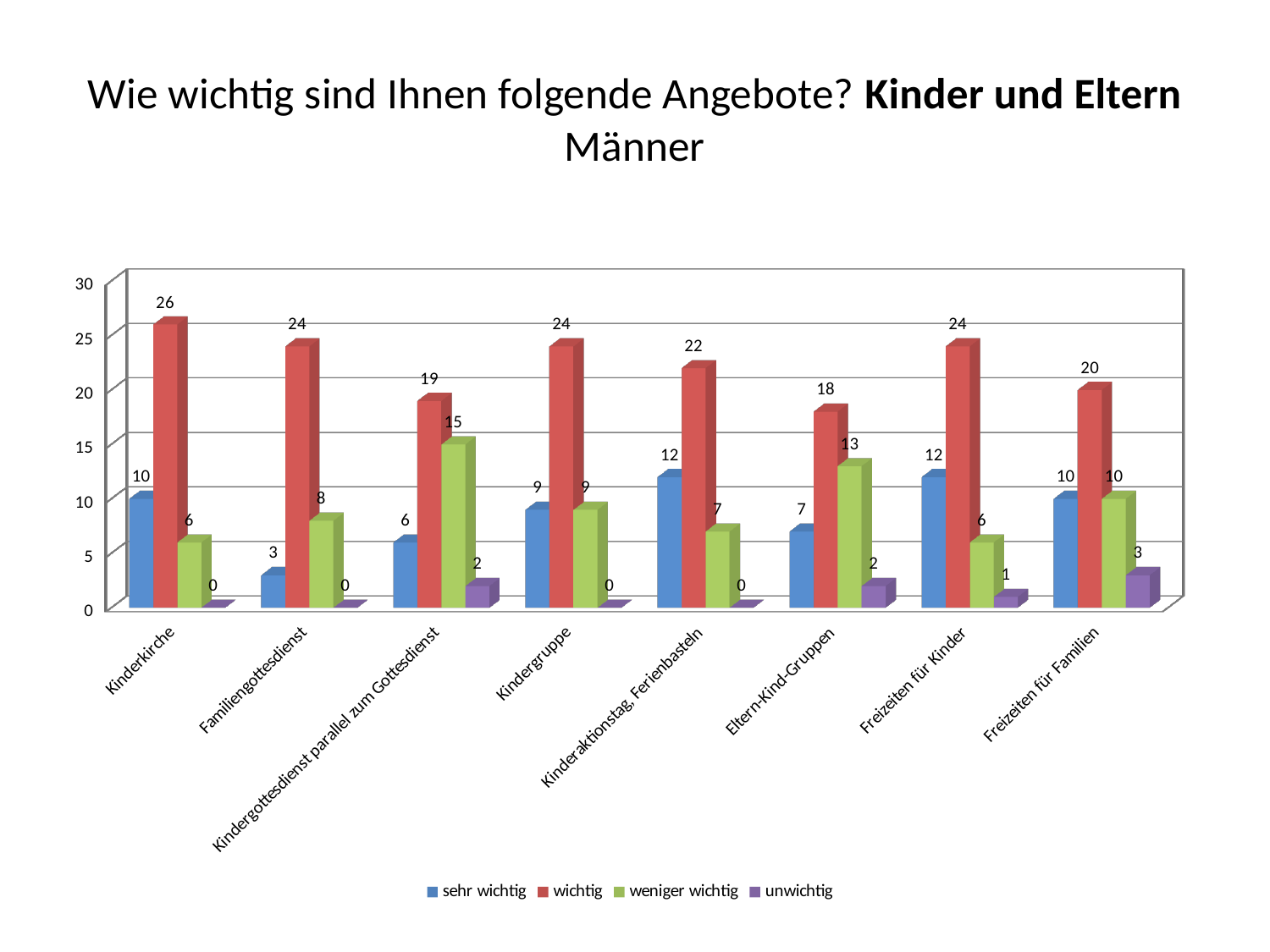
How many categories are shown on the x axis? 8 Which colour represents the "unwichtig" series? Purple What is the value for "unwichtig" for Freizeiten für Familien? 3 What is the value for "weniger wichtig" for Kindergottesdienst parallel zum Gottesdienst? 15 Which category has the lowest value for "sehr wichtig"? Familiengottesdienst Which is larger for Eltern-Kind-Gruppen: "sehr wichtig" or "weniger wichtig"? weniger wichtig Which category has the highest value for "wichtig"? Kinderkirche What is the difference between the "wichtig" and "sehr wichtig" values for Kinderaktionstag, Ferienbasteln? 10 What kind of chart is shown on the slide? Bar chart What is the value for "sehr wichtig" for Familiengottesdienst? 3 What is the value for "wichtig" for Kinderkirche? 26 How many series does the legend list? 4